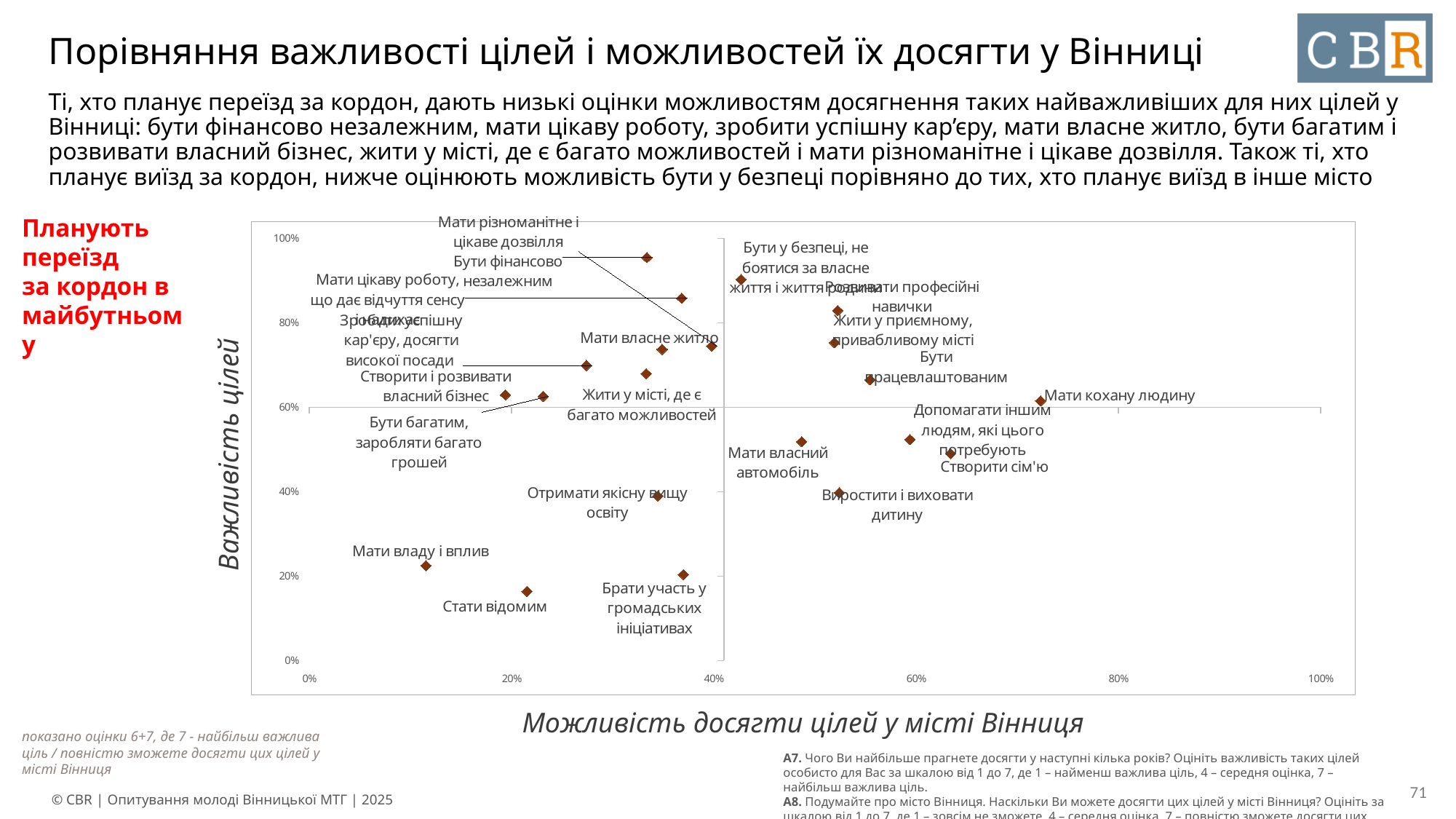
Is the Можливість досягти цілей value for Мати кохану людину greater or less than 60%? greater What is the title of the horizontal axis of the chart? Можливість досягти цілей у місті Вінниця Is the Важливість цілей value for Мати владу і вплив greater or less than 40%? less What kind of chart is shown on the slide? scatter chart What is the title of the vertical axis of the chart? Важливість цілей Which goal has the highest value on the horizontal axis (Можливість досягти цілей у місті Вінниця)? Мати кохану людину Which goal has a higher Важливість цілей value: Бути у безпеці, не боятися за власне життя і життя рідних or Стати відомим? Бути у безпеці, не боятися за власне життя і життя рідних Which goal has the lowest value on the horizontal axis (Можливість досягти цілей у місті Вінниця)? Мати владу і вплив Is the Можливість досягти цілей value for Стати відомим greater or less than 40%? less Which goal has a higher Можливість досягти цілей value: Виростити і виховати дитину or Мати владу і вплив? Виростити і виховати дитину Which goal has the highest value on the vertical axis (Важливість цілей)? Мати різноманітне і цікаве дозвілля